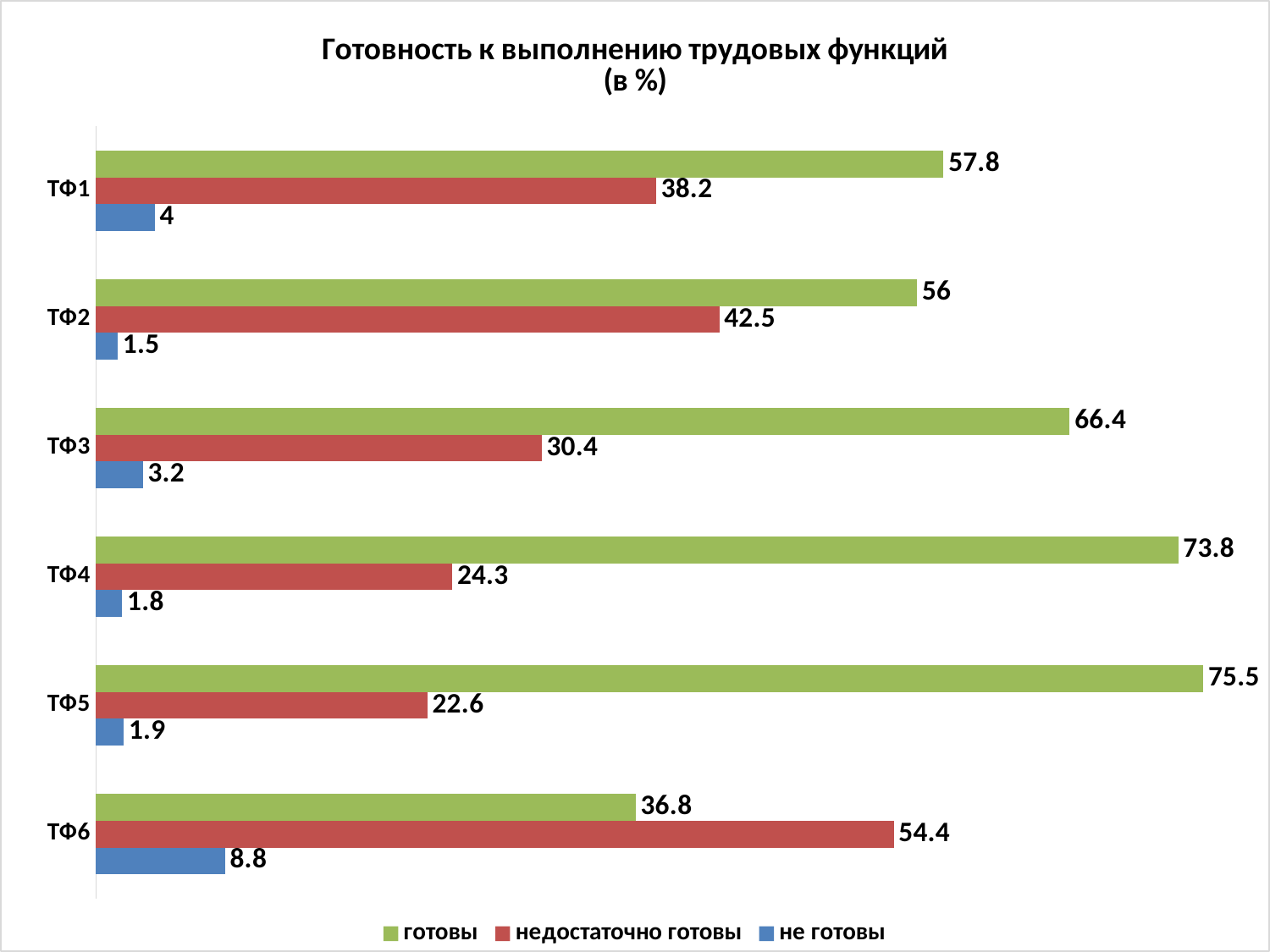
What is the title of the chart? Готовность к выполнению трудовых функций (в %) What is the difference between the "готовы" and "недостаточно готовы" values for ТФ4? 49.5 How many categories are shown on the chart? 6 Which is larger for ТФ6: "готовы" or "недостаточно готовы"? недостаточно готовы Which category has the highest value for "готовы"? ТФ5 Which category has the lowest value for "не готовы"? ТФ2 Which colour represents the "не готовы" series? blue How many series does the legend list? 3 What is the value for "готовы" for ТФ3? 66.4 What kind of chart is shown on the slide? bar chart What is the value for "не готовы" for ТФ1? 4 What is the value for "недостаточно готовы" for ТФ6? 54.4